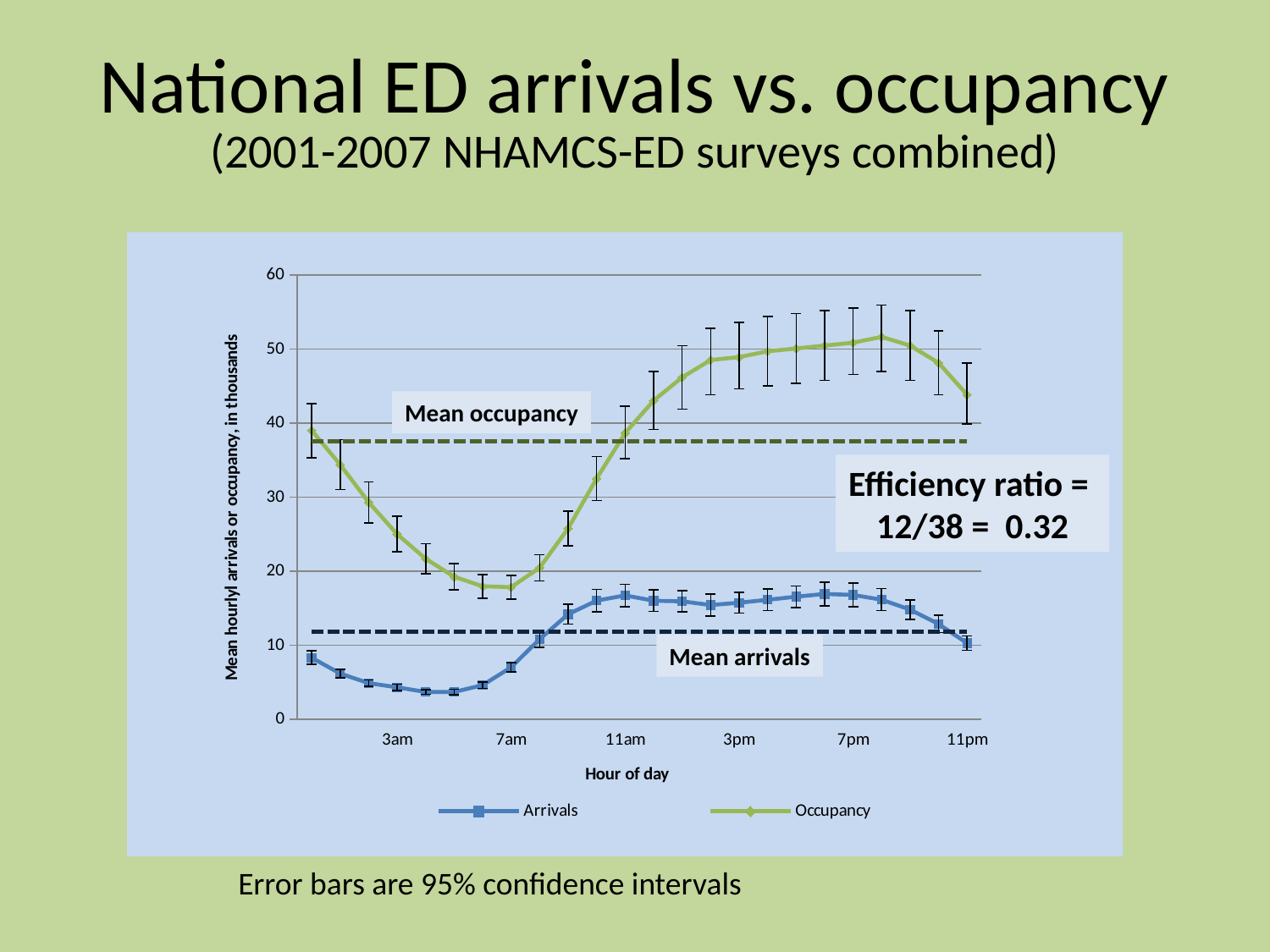
Is the Arrivals value at 3am greater or less than 10? less What is the title of the y axis? Mean hourlyl arrivals or occupancy, in thousands Does the Occupancy line rise or fall between 7am and 3pm? rise According to the annotation, what is the mean arrivals value used in the efficiency ratio? 12 What type of chart is shown on the slide? line chart Is the Arrivals value at 7pm greater or less than 20? less How many series does the legend list? 2 Is the Occupancy value at 7pm greater or less than 40? greater At 3am, which series has the higher value, Arrivals or Occupancy? Occupancy What efficiency ratio is stated on the chart? 0.32 What are the two series named in the legend? Arrivals and Occupancy According to the annotation, what is the mean occupancy value used in the efficiency ratio? 38